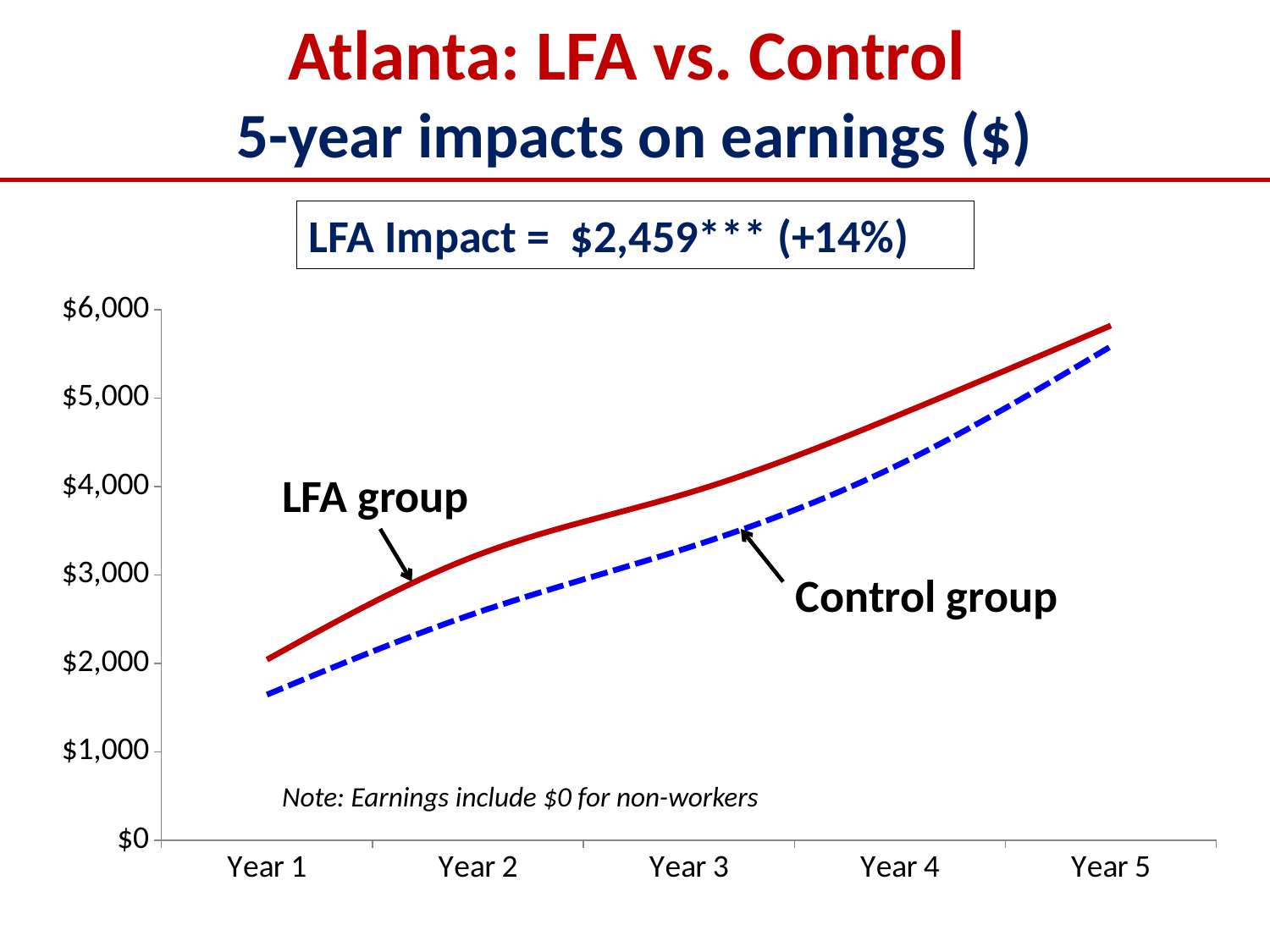
Is the value for the LFA group in Year 5 greater or less than $5,000? greater Which series is drawn as a dashed blue line? Control group How many years are shown along the x axis? 5 Is the value for the Control group in Year 1 greater or less than $2,000? less In Year 3, which group has higher earnings, the LFA group or the Control group? LFA group What kind of chart is shown on the slide? line chart How many series are plotted on the chart? 2 What LFA impact value is stated in the box above the chart? $2,459*** (+14%) Is the value for the Control group in Year 3 greater or less than $3,000? greater Do the earnings for the LFA group rise or fall from Year 1 to Year 5? rise Do the earnings for the Control group rise or fall from Year 1 to Year 5? rise